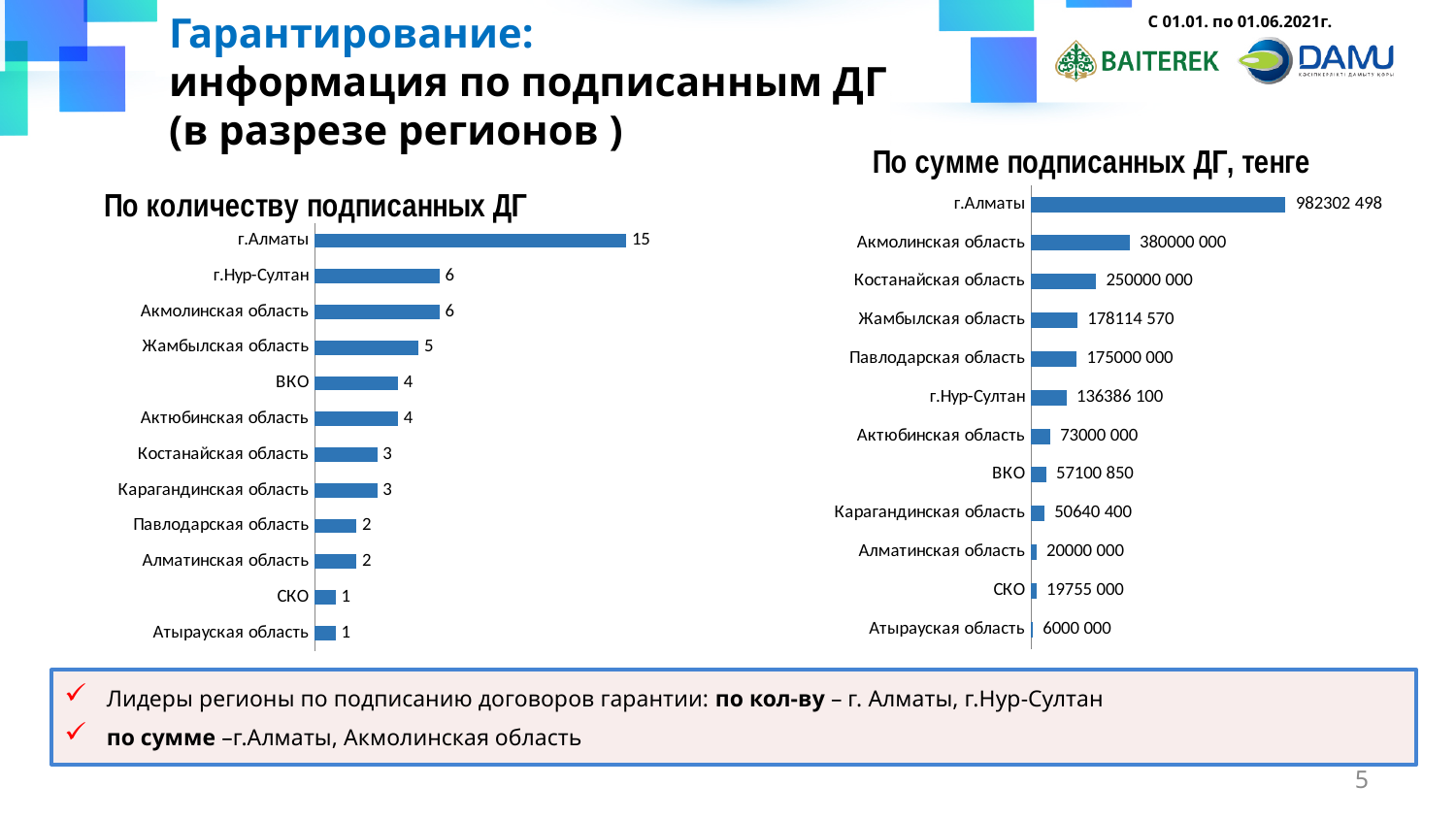
In the chart 'По количеству подписанных ДГ', what is the difference between г.Алматы and г.Нур-Султан? 9 In the chart 'По сумме подписанных ДГ, тенге', which category has the highest value? г.Алматы In the chart 'По сумме подписанных ДГ, тенге', what is the value for г.Нур-Султан? 136386 100 In the chart 'По количеству подписанных ДГ', what is the value for Жамбылская область? 5 In the chart 'По сумме подписанных ДГ, тенге', which is larger: ВКО or Актюбинская область? Актюбинская область In the chart 'По количеству подписанных ДГ', which category has the lowest value? СКО and Атырауская область (1 each) In the chart 'По количеству подписанных ДГ', how many categories are shown? 12 In the chart 'По сумме подписанных ДГ, тенге', what is the value for Акмолинская область? 380000 000 In the chart 'По сумме подписанных ДГ, тенге', which category has the lowest value? Атырауская область In the chart 'По сумме подписанных ДГ, тенге', what is the difference between Костанайская область and Павлодарская область? 75000 000 What type of chart is 'По сумме подписанных ДГ, тенге'? Bar chart In the chart 'По количеству подписанных ДГ', what is the value for г.Алматы? 15